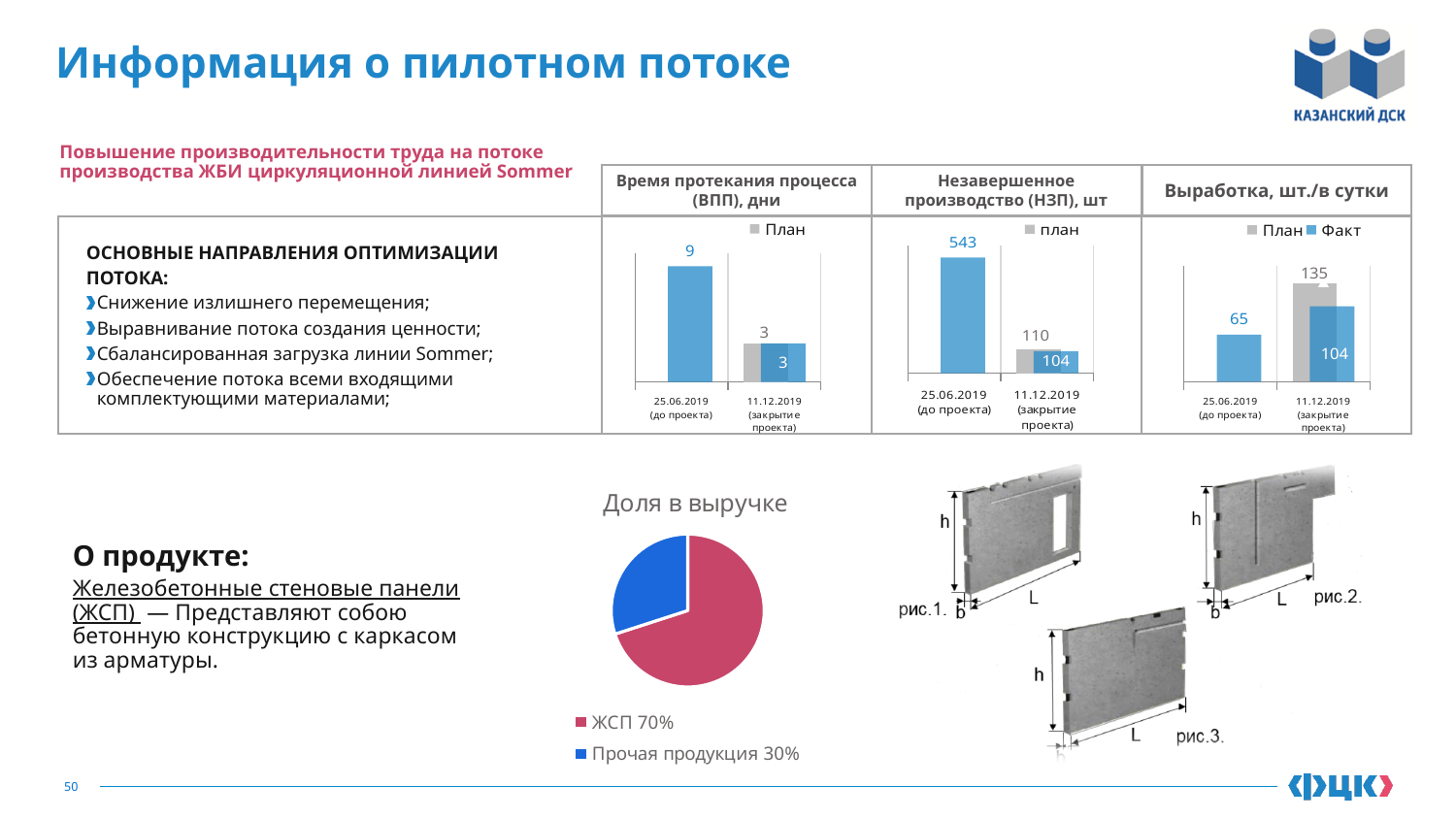
In the pie chart "Доля в выручке", what share does ЖСП have? 70% In the chart titled "Выработка, шт./в сутки", how many series does the legend list? 2 What kind of chart is the "Доля в выручке" chart? Pie chart In the chart titled "Выработка, шт./в сутки", what is the План value for 11.12.2019 (закрытие проекта)? 135 In the chart titled "Время протекания процесса (ВПП), дни", what is the value for 25.06.2019 (до проекта)? 9 In the chart titled "Незавершенное производство (НЗП), шт", what is the difference between the 25.06.2019 value and the план value for 11.12.2019? 433 In the chart titled "Незавершенное производство (НЗП), шт", what is the value for 25.06.2019 (до проекта)? 543 In the chart titled "Выработка, шт./в сутки", what is the Факт value for 11.12.2019 (закрытие проекта)? 104 In the chart titled "Незавершенное производство (НЗП), шт", which is larger for 11.12.2019: the план value or the факт value? план (110) In the chart titled "Выработка, шт./в сутки", what is the difference between the План and Факт values for 11.12.2019? 31 In the pie chart "Доля в выручке", which slice is the largest? ЖСП In the chart titled "Время протекания процесса (ВПП), дни", what is the План value for 11.12.2019 (закрытие проекта)? 3